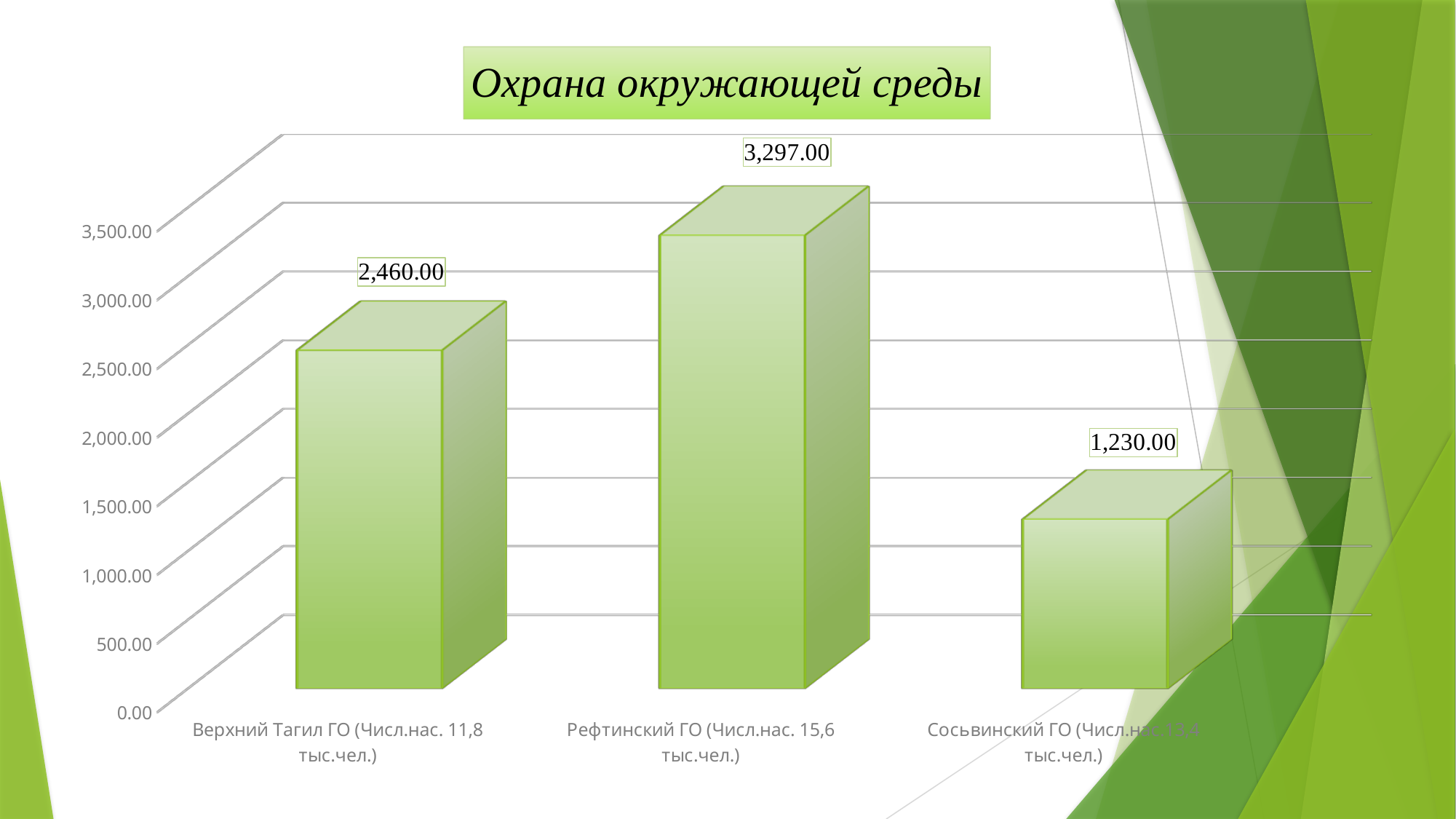
Which is larger, the value for Верхний Тагил ГО or the value for Сосьвинский ГО? Верхний Тагил ГО How many categories are shown in the chart? 3 Is the value for Сосьвинский ГО greater or less than 1,500.00? less What is the value for Сосьвинский ГО? 1,230.00 Which category has the highest value? Рефтинский ГО What is the difference between the values for Верхний Тагил ГО and Сосьвинский ГО? 1,230.00 What is the value for Верхний Тагил ГО? 2,460.00 Which category has the lowest value? Сосьвинский ГО What is the title of the chart? Охрана окружающей среды What is the value for Рефтинский ГО? 3,297.00 What kind of chart is shown on the slide? Bar chart What is the difference between the values for Рефтинский ГО and Верхний Тагил ГО? 837.00